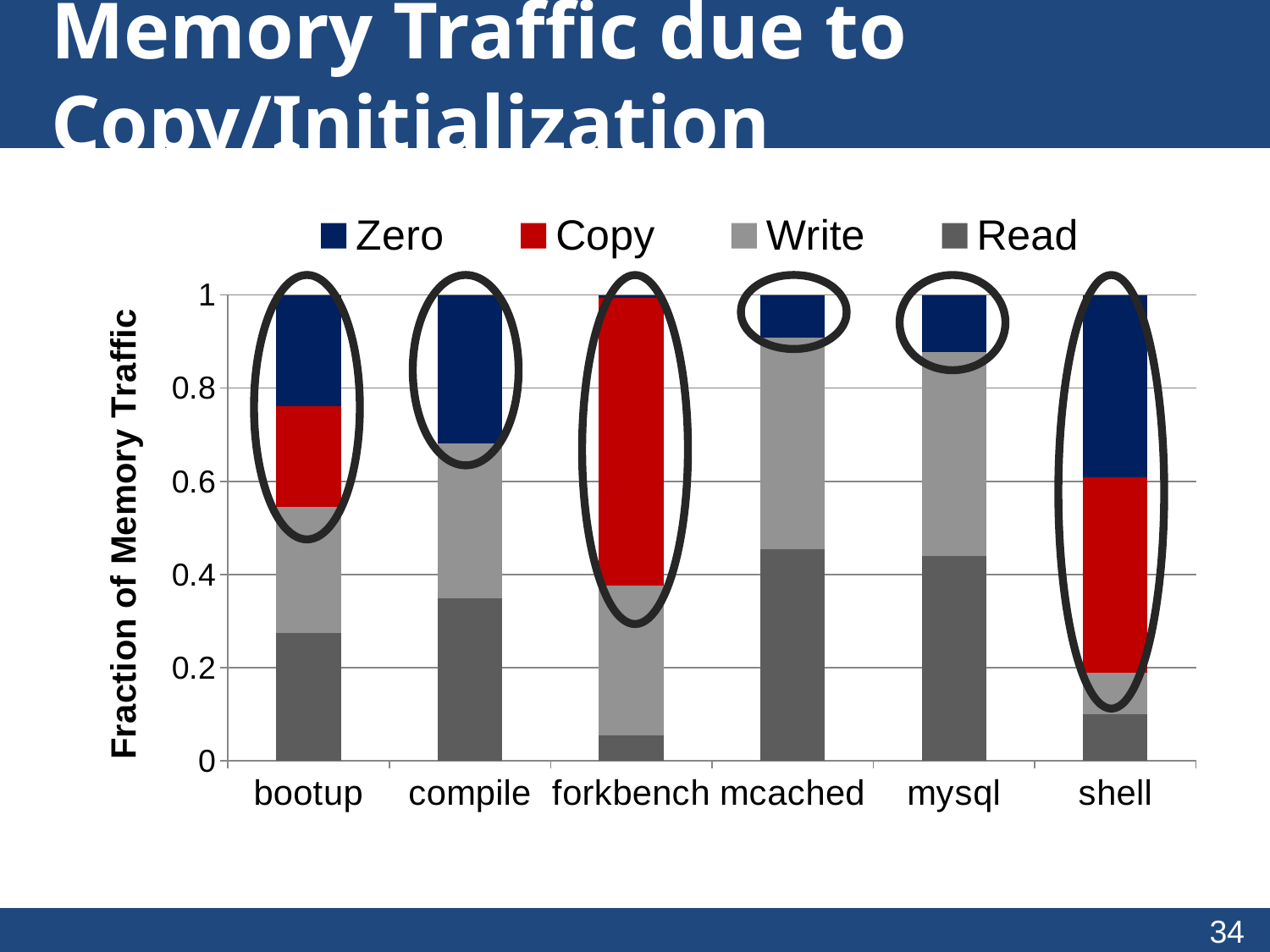
How many series does the legend list? 4 How many categories are shown on the x axis? 6 Which colour represents the Copy series in the legend? red What is the total height of the stacked bar for mysql? 1 Is the Read value for mcached greater or less than 0.4? greater What is the y-axis title of the chart? Fraction of Memory Traffic Which category has the largest Copy segment? forkbench What kind of chart is shown on the slide? stacked bar chart Is the Read value for shell greater or less than 0.2? less Which category has the smallest Read segment? forkbench Which category has the largest Zero segment? shell Which has a larger Read segment, compile or bootup? compile